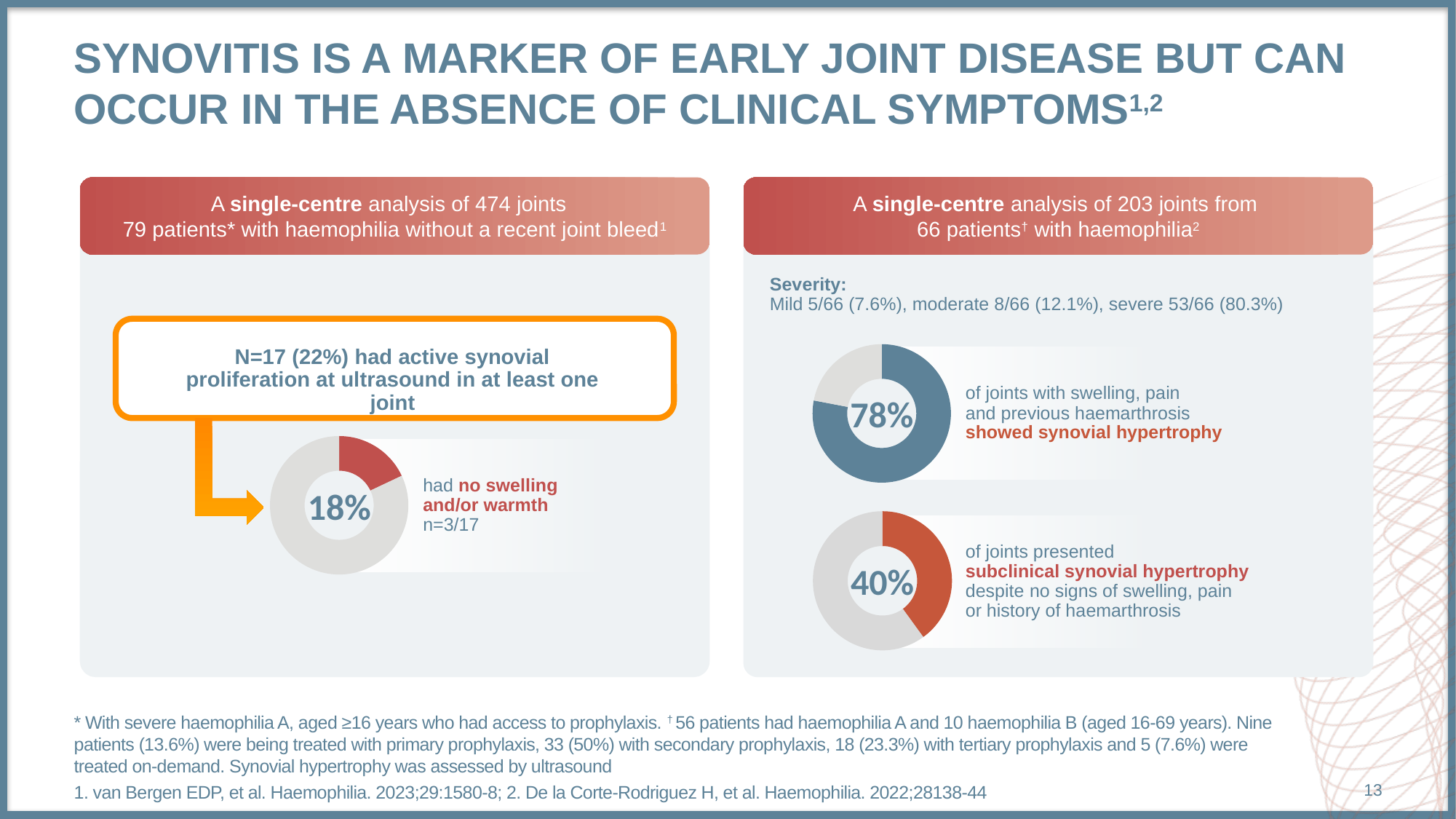
In the left-hand donut chart, what percentage had no swelling and/or warmth? 18% In the lower right donut chart, what percentage of joints presented subclinical synovial hypertrophy despite no signs of swelling, pain or history of haemarthrosis? 40% Which is larger: the 78% donut chart value for joints with swelling, pain and previous haemarthrosis, or the 40% donut chart value for subclinical synovial hypertrophy? 78% (joints with swelling, pain and previous haemarthrosis) What colour is the highlighted slice in the upper right donut chart showing 78%? Blue-grey In the left-hand donut chart, what fraction of patients does the 18% slice correspond to? n=3/17 How many donut charts are shown on the slide? 3 Is the value shown in the lower right donut chart greater or less than 50%? less What is the difference in percentage points between the upper right donut chart (78%) and the lower right donut chart (40%)? 38 percentage points Is the value shown in the upper right donut chart greater or less than 50%? greater In the upper right donut chart, what percentage of joints with swelling, pain and previous haemarthrosis showed synovial hypertrophy? 78% Which of the three donut charts on the slide shows the smallest percentage? The left-hand donut chart (18%) What kind of chart is used to show the 18% value on the left of the slide? Donut (pie) chart